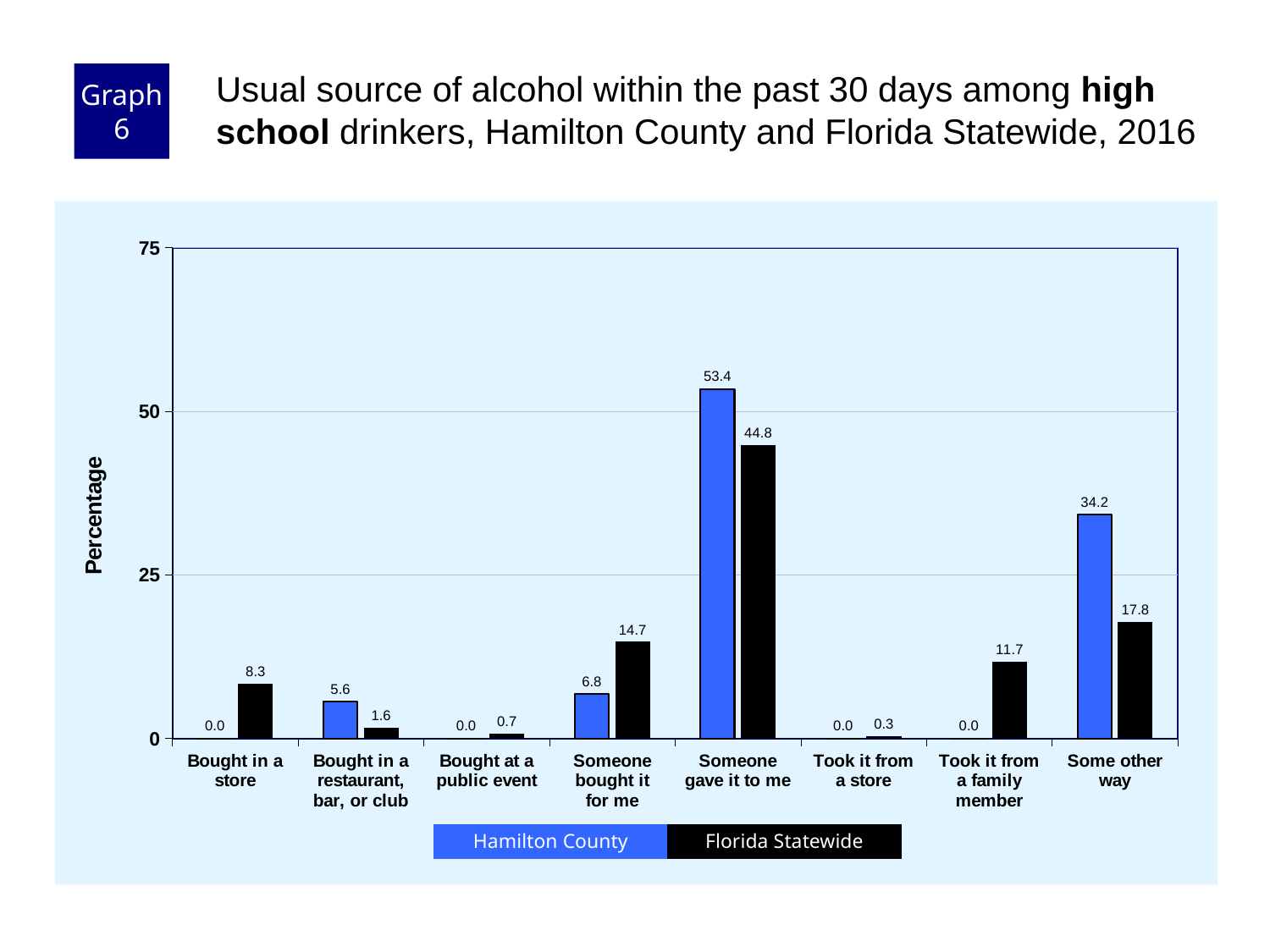
What is the Hamilton County value for "Some other way"? 34.2 Which category has the highest Florida Statewide value? Someone gave it to me What is the Florida Statewide value for "Took it from a family member"? 11.7 What is the difference between the Hamilton County and Florida Statewide values for "Some other way"? 16.4 Which category has the lowest Florida Statewide value? Took it from a store How many source categories are shown on the x axis? 8 What is the difference between the Hamilton County and Florida Statewide values for "Someone gave it to me"? 8.6 What kind of chart is shown on the slide? Bar chart Which colour represents Hamilton County in the chart? Blue What is the Hamilton County value for "Someone gave it to me"? 53.4 For "Someone bought it for me", which is larger: Hamilton County or Florida Statewide? Florida Statewide How many series does the legend list? 2